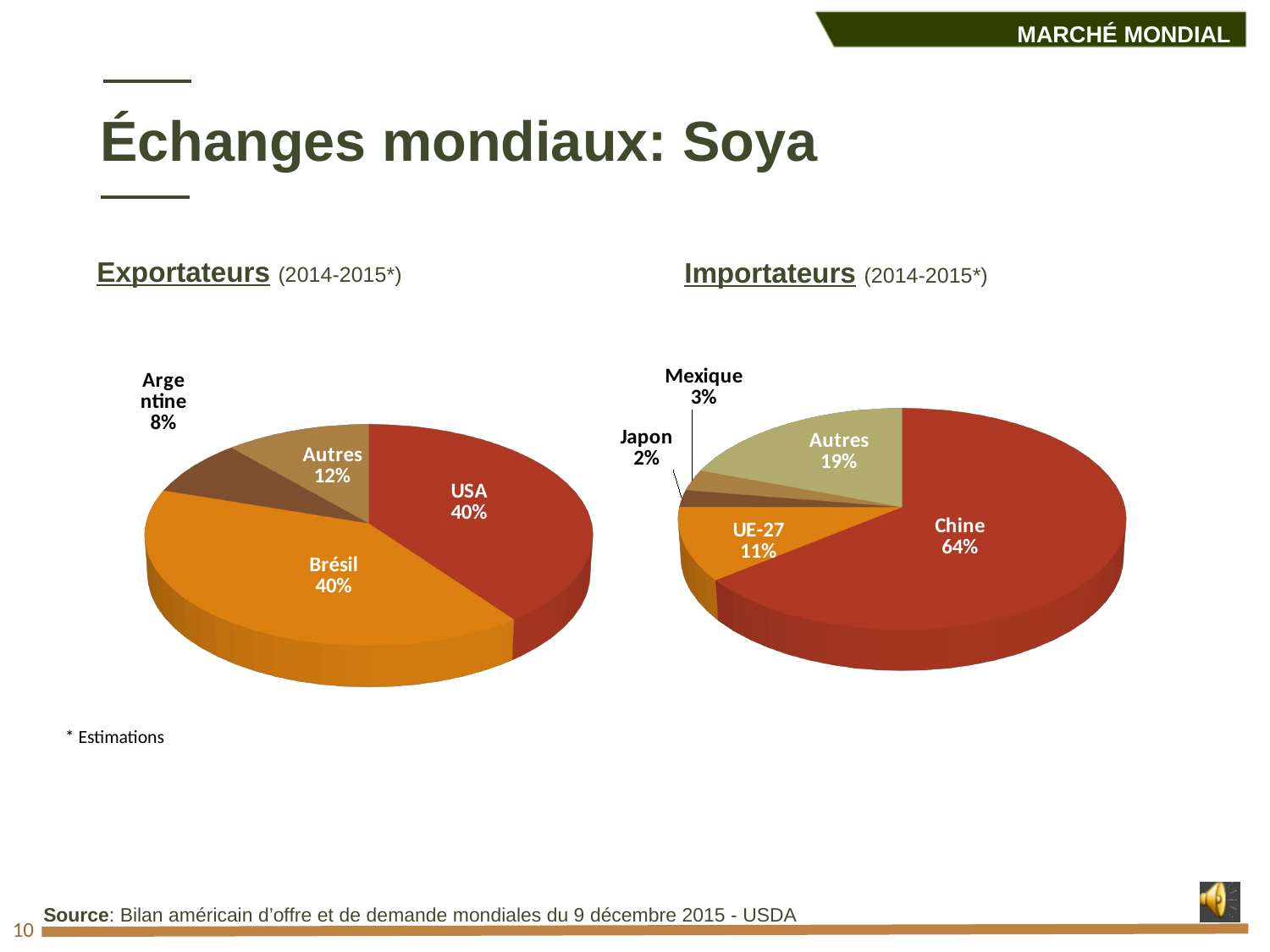
In the Importateurs pie chart, which is larger, the share of Mexique or the share of Japon? Mexique In the Importateurs pie chart, which category has the largest share? Chine In the Importateurs pie chart, which category has the smallest share? Japon What kind of chart is used for the Importateurs data? Pie chart In the Exportateurs pie chart, what share does Brésil have? 40% In the Importateurs pie chart, what is the difference between the shares of Chine and Autres? 45% In the Exportateurs pie chart, which category has the smallest share? Argentine In the Exportateurs pie chart, what share does Argentine have? 8% How many categories are shown in the Exportateurs pie chart? 4 In the Exportateurs pie chart, what is the difference between the shares of Autres and Argentine? 4% In the Importateurs pie chart, what share does Chine have? 64% In the Importateurs pie chart, what share does UE-27 have? 11%